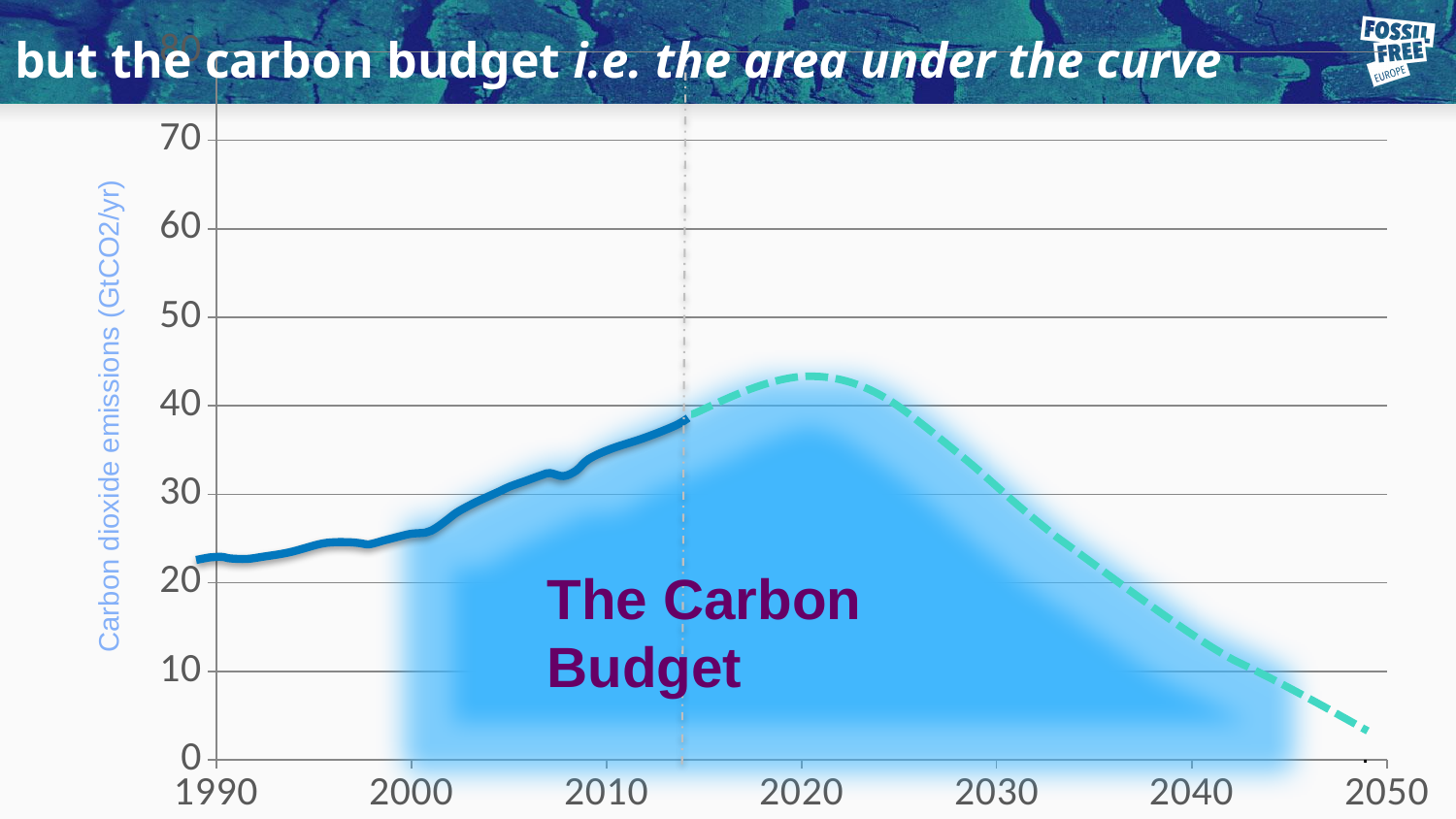
Do the emissions rise or fall along the dashed line from 2020 to 2050? fall What kind of chart is shown on the slide? line chart Which is larger, the value for 2000 or the value for 2010? 2010 What label is written inside the shaded blue area under the curve? The Carbon Budget Is the value at the end of the dashed line, near 2050, greater or less than 10? less Is the value for 2040 greater or less than 20? less Do the emissions rise or fall along the solid line from 1990 to 2014? rise Is the value for 2020 greater or less than 40? greater Around which year on the x axis does the curve reach its highest point? 2020 What is the title of the vertical axis? Carbon dioxide emissions (GtCO2/yr)